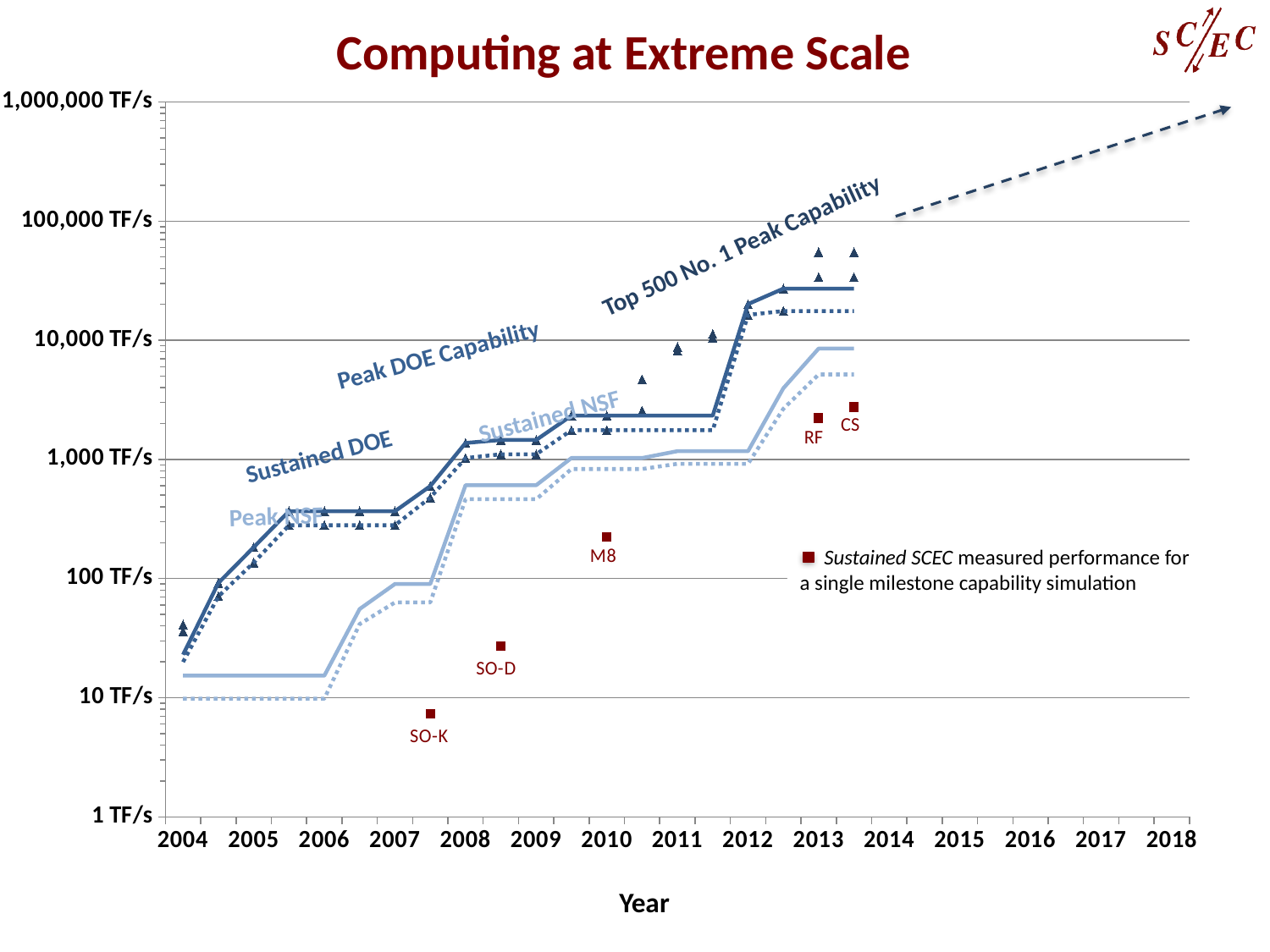
Is the value for the SO-D milestone greater or less than 10 TF/s? greater What kind of chart is shown on the slide? line chart Which has the larger measured performance, the SO-K milestone or the M8 milestone? M8 What is the label of the x axis? Year Is the value for the SO-K milestone greater or less than 10 TF/s? less Is the Peak DOE Capability line in 2013 greater or less than 10,000 TF/s? greater How many Sustained SCEC milestone simulation points are plotted on the chart? 5 Which Sustained SCEC milestone simulation has the lowest measured performance? SO-K Does the Peak NSF line rise or fall from 2004 to 2013? rise What is the title of the chart? Computing at Extreme Scale